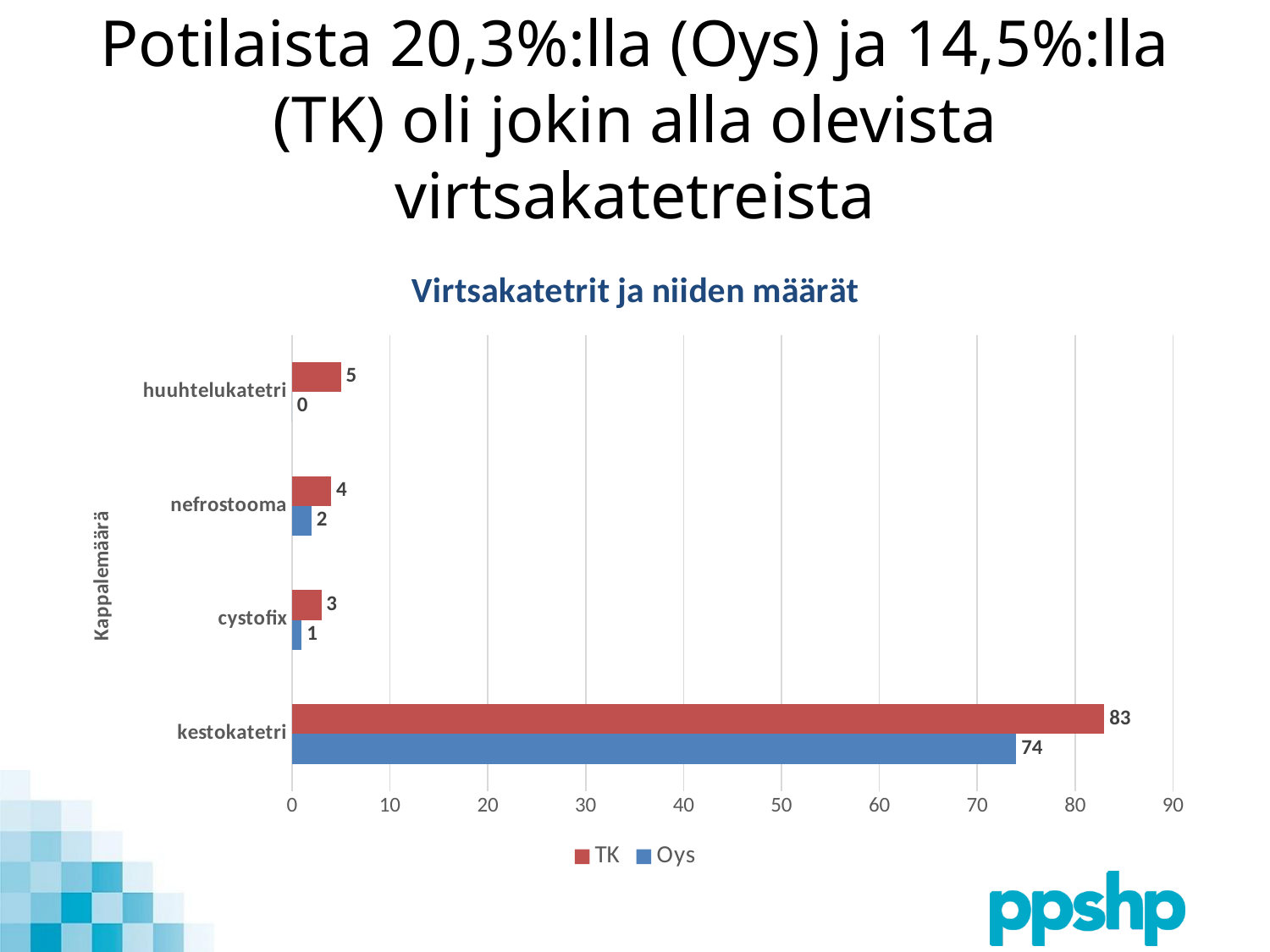
What is the Oys value for kestokatetri? 74 What is the title of the chart? Virtsakatetrit ja niiden määrät What is the Oys value for huuhtelukatetri? 0 Which category has the lowest Oys value? huuhtelukatetri What is the TK value for kestokatetri? 83 How many series does the legend list? 2 What is the TK value for nefrostooma? 4 Which is larger for cystofix, the TK value or the Oys value? TK What is the difference between the TK and Oys values for kestokatetri? 9 Which category has the highest TK value? kestokatetri How many categories are shown on the chart? 4 What kind of chart is shown on the slide? bar chart